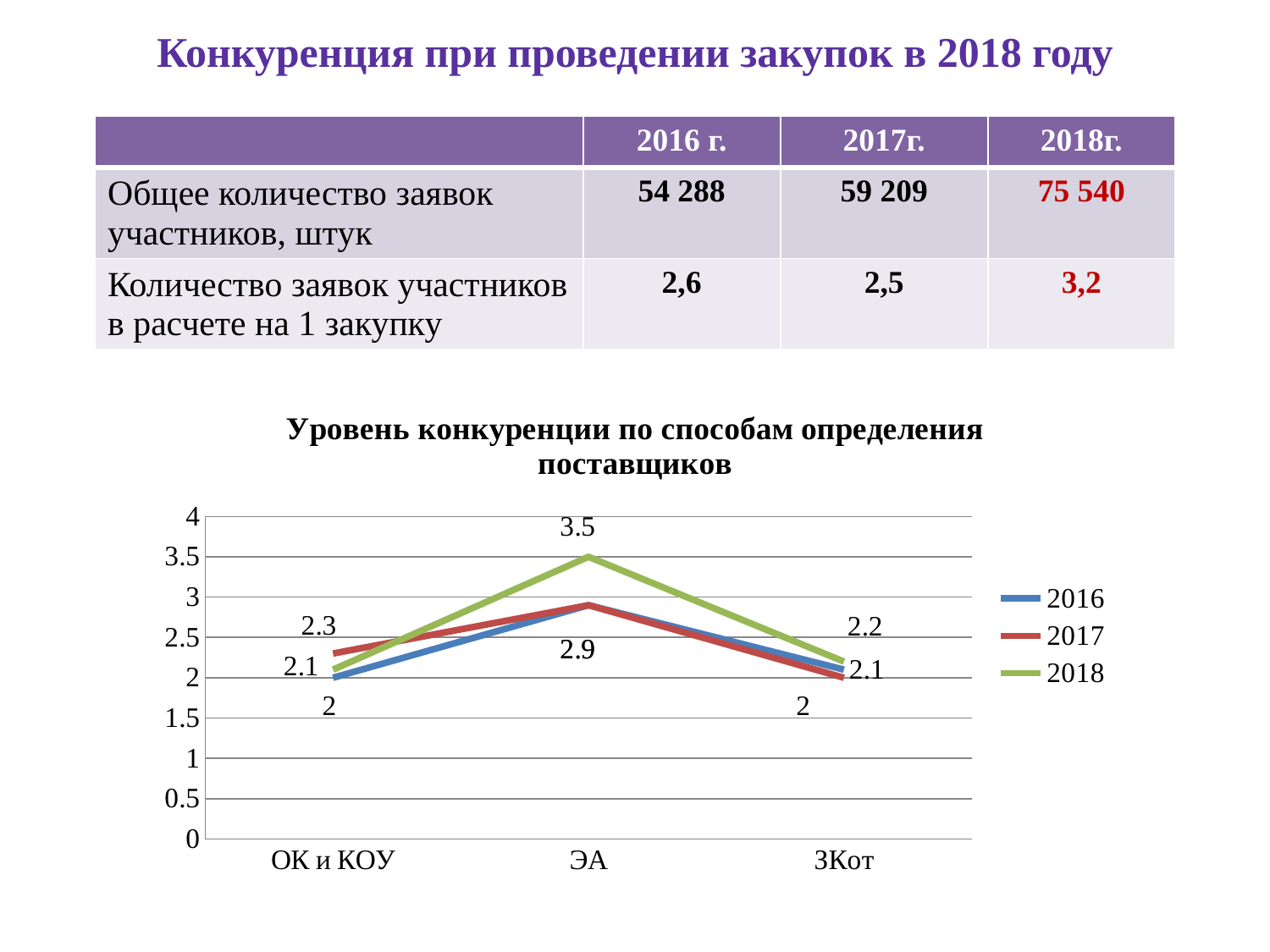
What is the value of the 2018 series for ЗКот? 2.2 What is the difference between the 2018 values for ЭА and ЗКот? 1.3 How many categories are shown on the x axis of the chart? 3 What is the value of the 2017 series for ОК и КОУ? 2.3 What is the value of the 2016 series for ОК и КОУ? 2 In the 2018 series, which is larger: the value for ЭА or the value for ЗКот? ЭА How many series does the legend of the chart list? 3 Which years are listed in the chart's legend? 2016, 2017, 2018 What kind of chart is shown under the title "Уровень конкуренции по способам определения поставщиков"? line chart Is the 2018 value for ЭА greater or less than 3? greater For the 2018 series, which category has the highest value? ЭА What is the value of the 2018 series for ЭА? 3.5